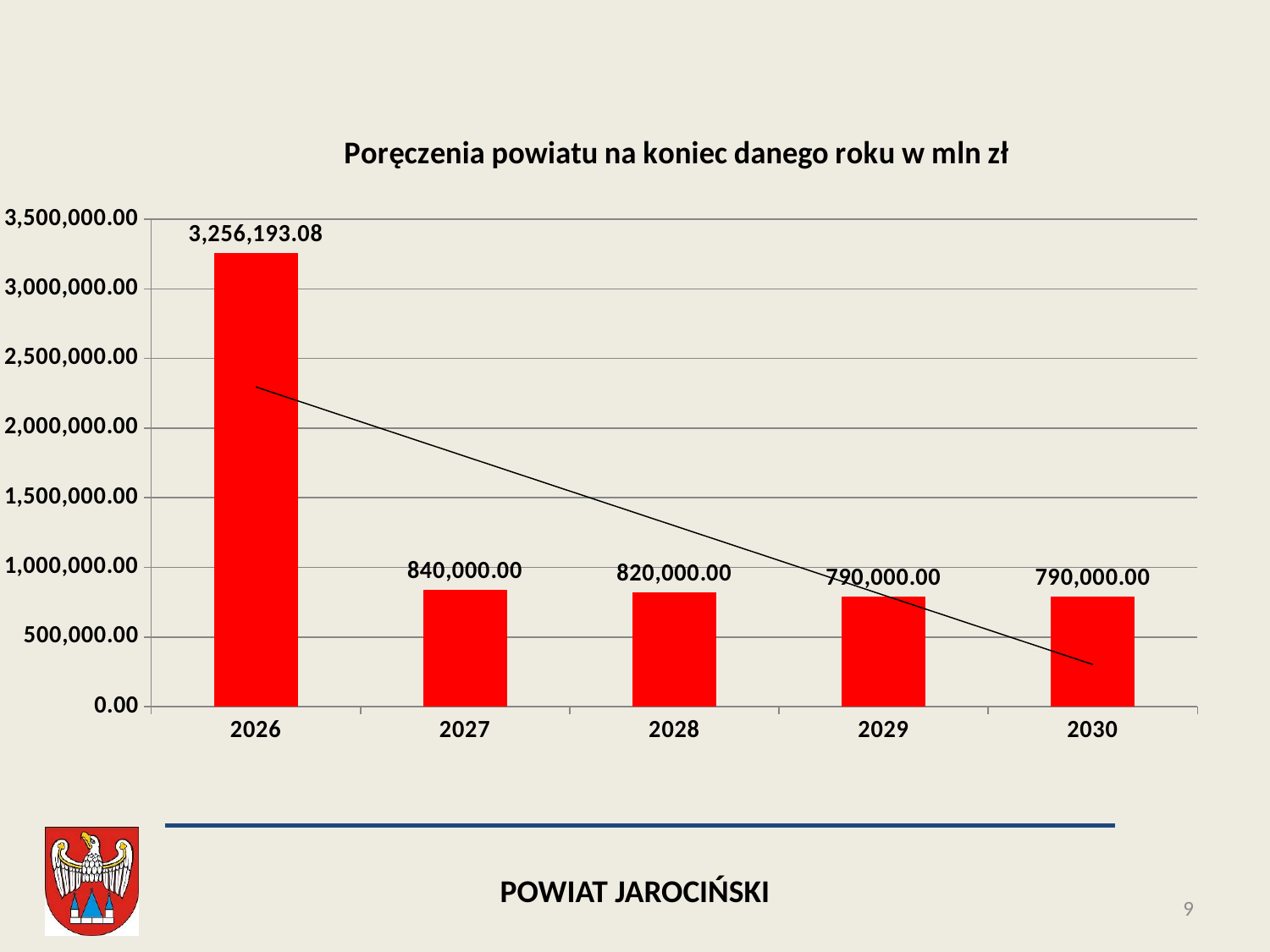
Which year has the highest value? 2026 How many years are shown on the x axis? 5 Is the value for 2028 greater or less than 1,000,000.00? less What kind of chart is this? bar chart What is the value for 2027? 840,000.00 What is the value for 2028? 820,000.00 What is the value for 2026? 3,256,193.08 What is the title of the chart? Poręczenia powiatu na koniec danego roku w mln zł What is the value for 2029? 790,000.00 What is the difference between the values for 2027 and 2028? 20,000.00 What is the difference between the values for 2026 and 2027? 2,416,193.08 Which is larger, the value for 2027 or the value for 2029? 2027